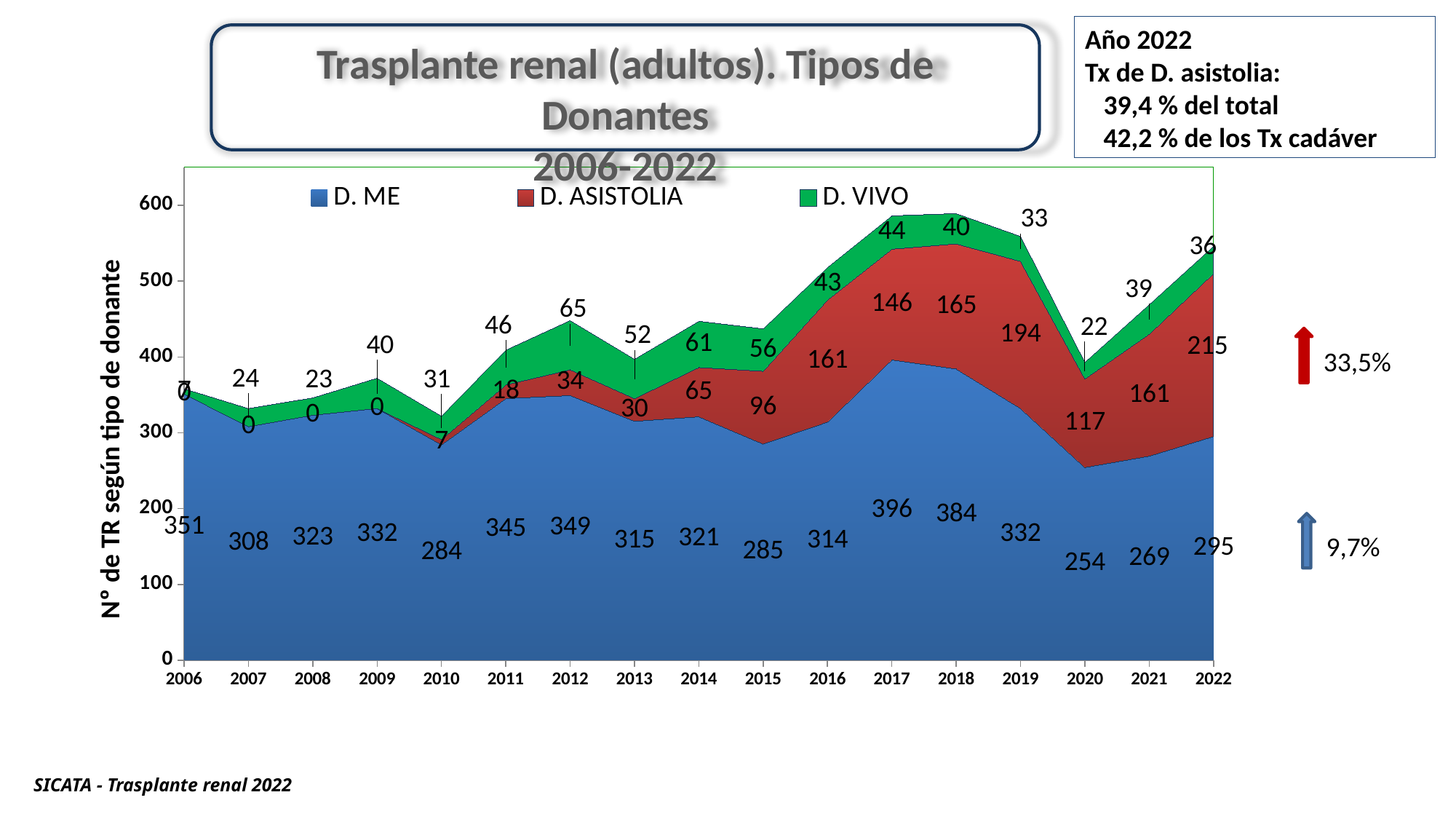
How many series does the legend list? 3 What kind of chart is shown? Stacked area chart What is the difference between the D. ASISTOLIA values in 2022 and 2021? 54 What is the total of the three series in 2022? 546 How many years are shown on the x axis? 17 What is the value of D. VIVO in 2012? 65 Which year has the larger D. VIVO value, 2014 or 2015? 2014 In which year is the D. ME value highest? 2017 What is the value of D. ME in 2017? 396 What is the value of D. ASISTOLIA in 2022? 215 In which year is the D. ME value lowest? 2020 In which year is the D. ASISTOLIA value highest? 2022